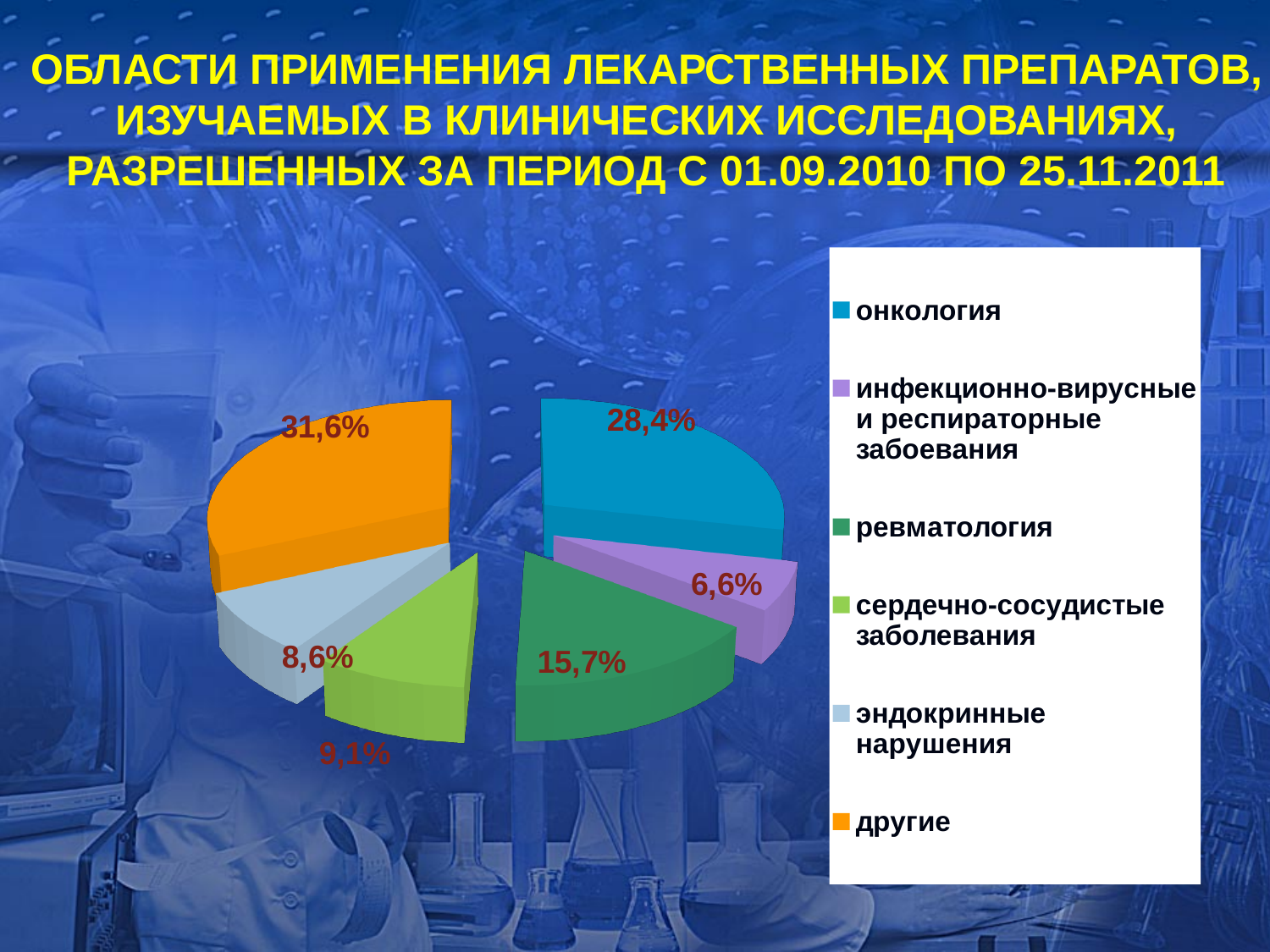
What is the difference in percentage points between другие and онкология? 3,2 What is the combined share of онкология and ревматология? 44,1% How many categories does the pie chart show? 6 What type of chart is shown on the slide? pie chart What is the value shown for ревматология? 15,7% Which is larger, the slice for ревматология or the slice for сердечно-сосудистые заболевания? ревматология Which category has the smallest slice of the pie? инфекционно-вирусные и респираторные забоевания What share of the pie does онкология account for? 28,4% Which category has the largest slice of the pie? другие What percentage is shown for инфекционно-вирусные и респираторные забоевания? 6,6% What is the value for эндокринные нарушения? 8,6% What colour is the slice for другие? orange